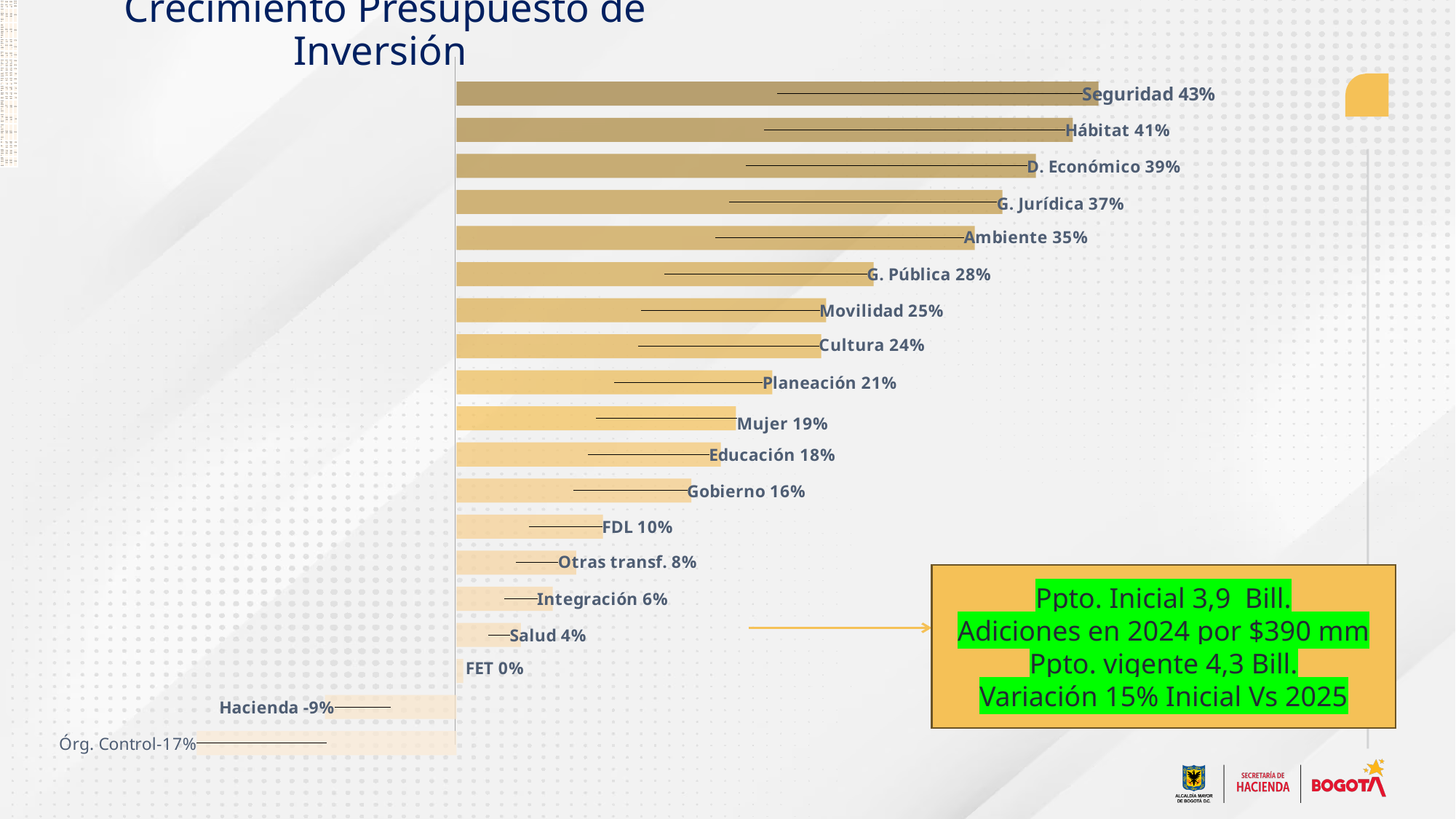
What is the value for Hacienda? -9% What is the value for Movilidad? 25% What is the difference between the values for Hábitat and Ambiente? 6% What is the title of the chart? Crecimiento Presupuesto de Inversión What is the value for FET? 0% What kind of chart is shown on the slide? Bar chart Which category has the highest value? Seguridad Which is larger, the value for Cultura or the value for Educación? Cultura What is the value for Seguridad? 43% How many categories are shown in the chart? 19 What is the difference between the values for Seguridad and Órg. Control? 60% Which category has the lowest value? Órg. Control